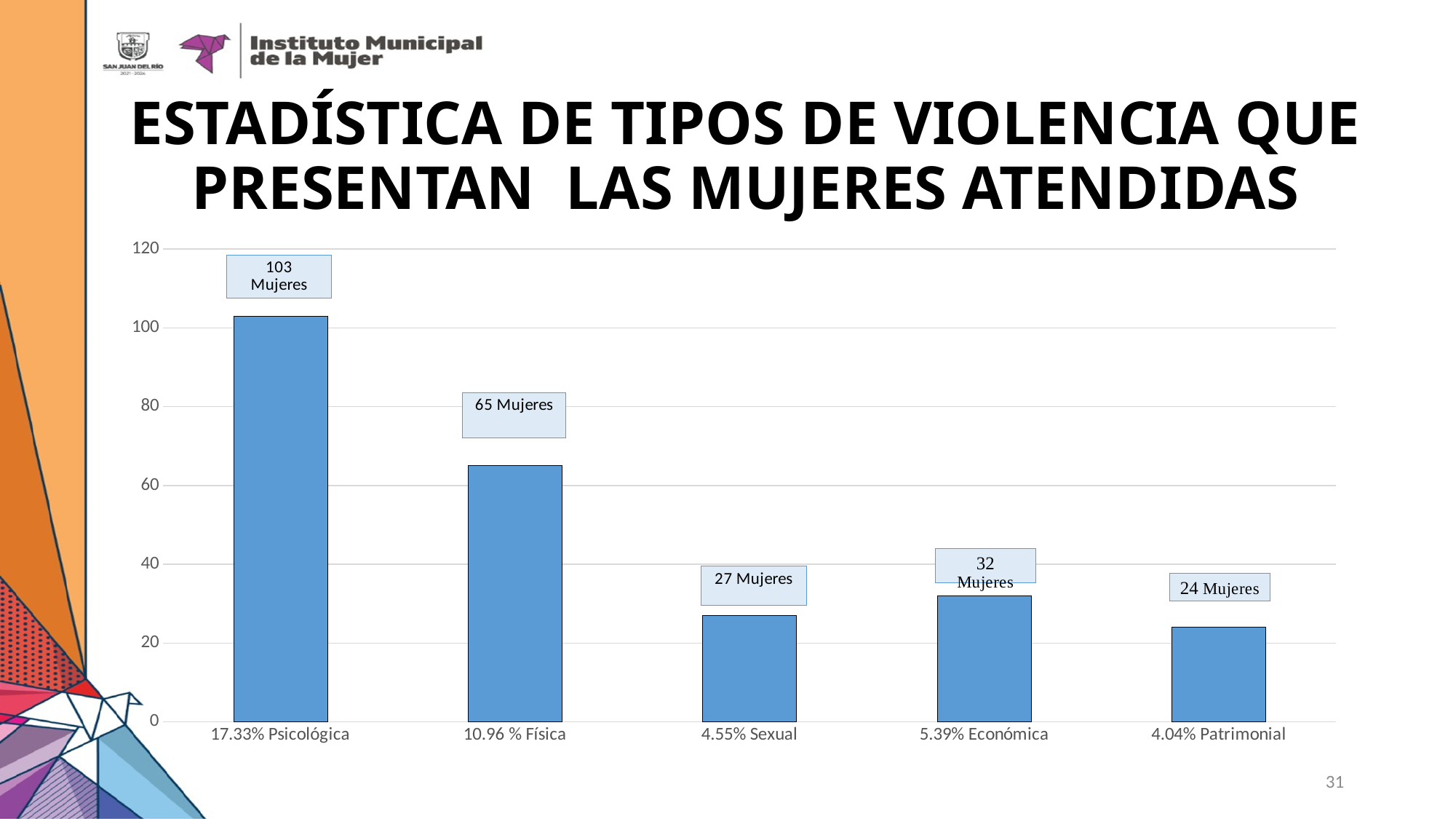
What kind of chart is shown on the slide? bar chart How many categories are shown on the x axis? 5 Is the value for Física greater or less than 60? greater What percentage is shown in the x-axis label for the Sexual category? 4.55% Which is larger, the value for Sexual or the value for Económica? Económica What is the value labelled for the Física bar? 65 Mujeres Which type of violence has the highest bar? Psicológica How many women are shown for the Patrimonial category? 24 Mujeres What is the difference between the Psicológica and Física values? 38 How many women are shown for the Psicológica category? 103 Mujeres Which type of violence has the lowest bar? Patrimonial What is the difference between the Económica and Sexual values? 5